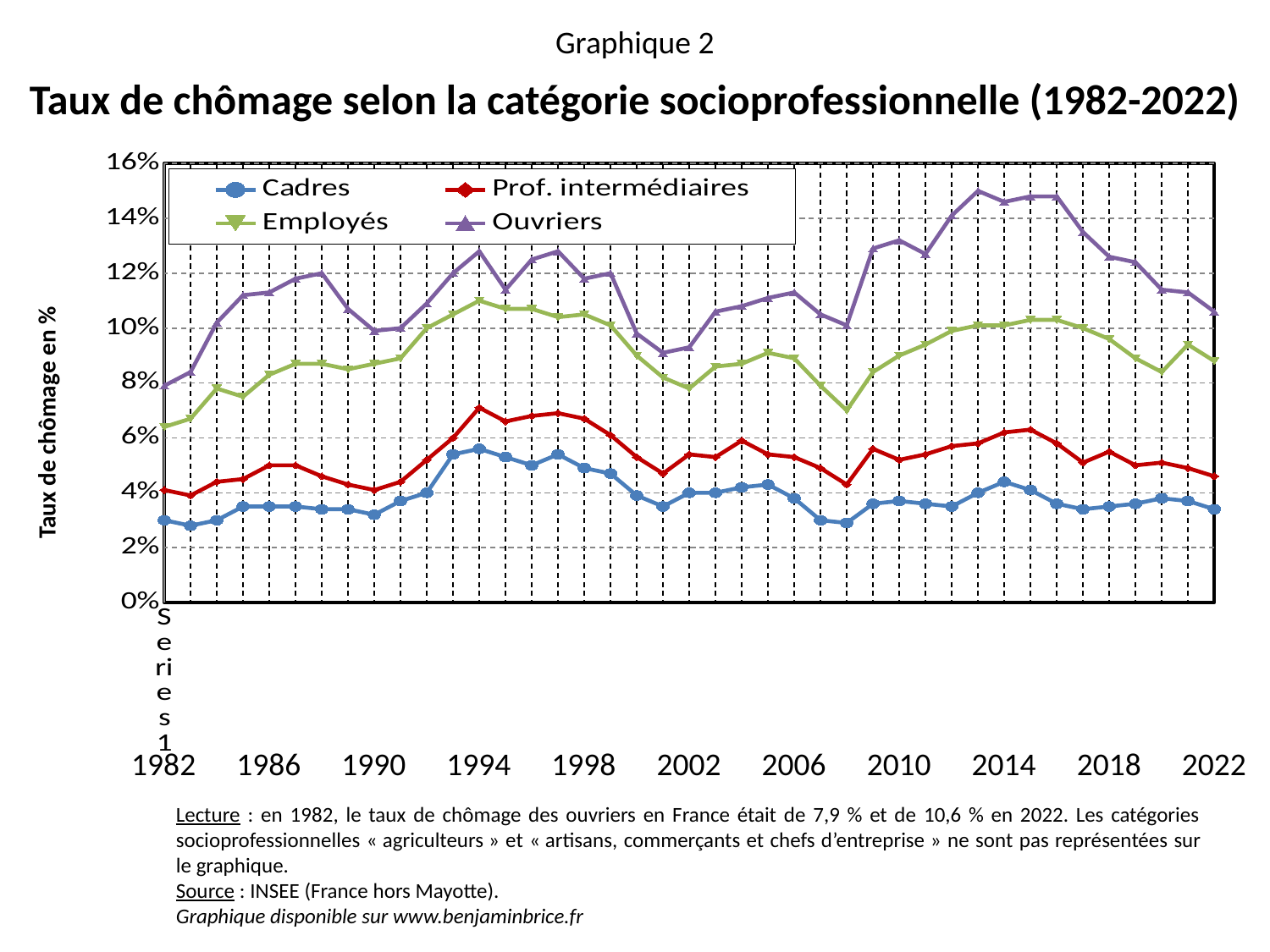
Which socioprofessional category has the highest unemployment rate across the whole period? Ouvriers According to the slide, what was the unemployment rate of ouvriers in 2022? 10,6 % Is the value for Ouvriers in 2014 greater or less than 14%? greater According to the slide, what was the unemployment rate of ouvriers in 1982? 7,9 % Is the value for Employés in 1994 greater or less than 10%? greater Is the value for Cadres in 1982 greater or less than 4%? less How many series does the legend list? 4 Which socioprofessional category has the lowest unemployment rate across the whole period? Cadres By how many percentage points did the unemployment rate of ouvriers change between 1982 and 2022? 2,7 points What kind of chart is shown on the slide? line chart In 2022, which is larger: the unemployment rate of Employés or of Prof. intermédiaires? Employés Does the unemployment rate of Ouvriers rise or fall between 2016 and 2022? fall